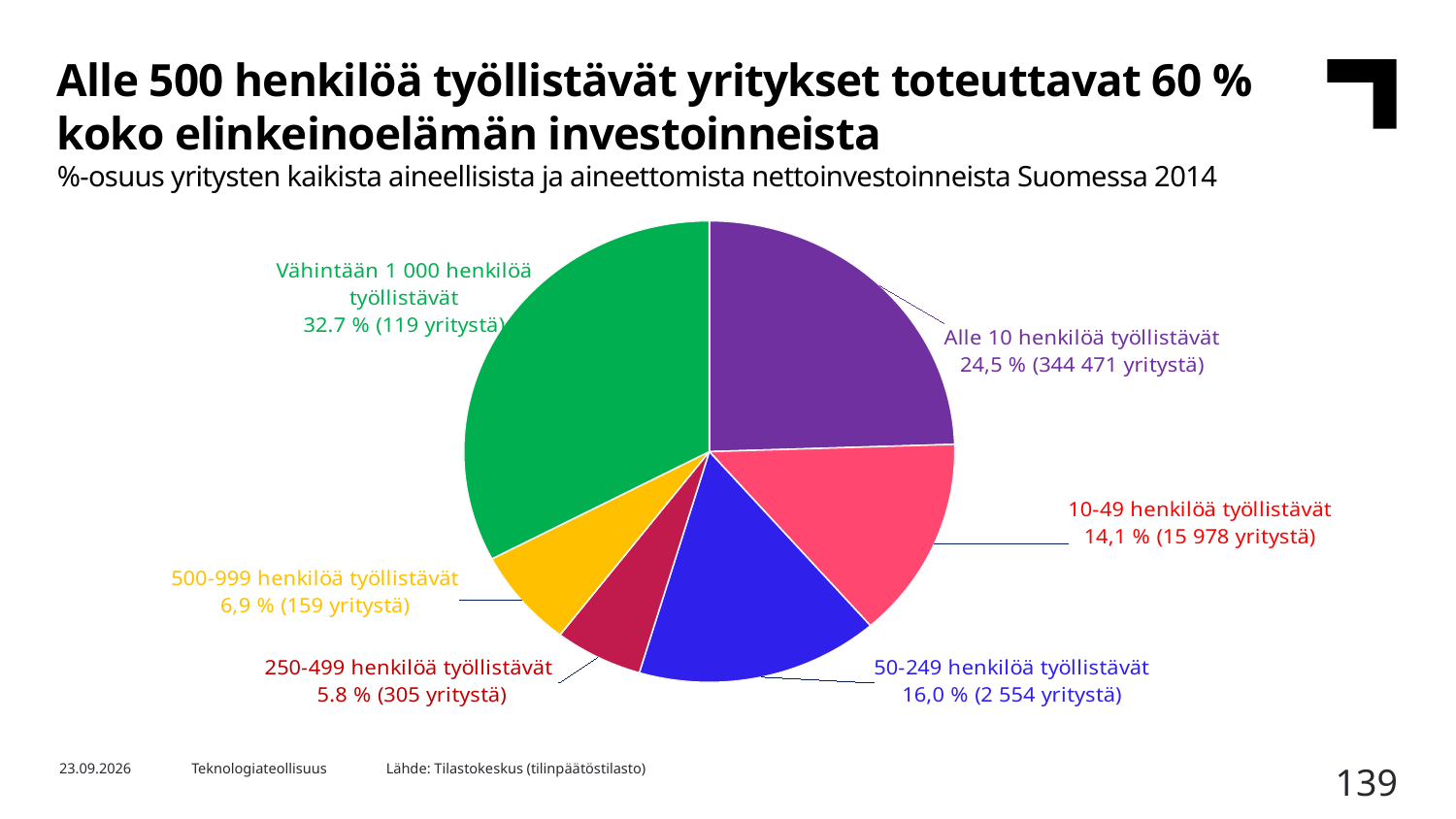
Which has a larger share: '50-249 henkilöä työllistävät' or '10-49 henkilöä työllistävät'? 50-249 henkilöä työllistävät How many companies are in the 'Alle 10 henkilöä työllistävät' category? 344 471 What share of investments is attributed to 'Vähintään 1 000 henkilöä työllistävät'? 32.7 % What colour is the slice for '500-999 henkilöä työllistävät'? yellow What kind of chart is shown on the slide? pie chart Which category has the smallest share of the pie? 250-499 henkilöä työllistävät What share of investments is attributed to 'Alle 10 henkilöä työllistävät'? 24,5 % What is the difference in percentage points between the shares of 'Vähintään 1 000 henkilöä työllistävät' and 'Alle 10 henkilöä työllistävät'? 8.2 How many companies are in the '50-249 henkilöä työllistävät' category? 2 554 What share of investments is attributed to '500-999 henkilöä työllistävät'? 6,9 % Which category has the largest share of the pie? Vähintään 1 000 henkilöä työllistävät How many slices does the pie chart have? 6